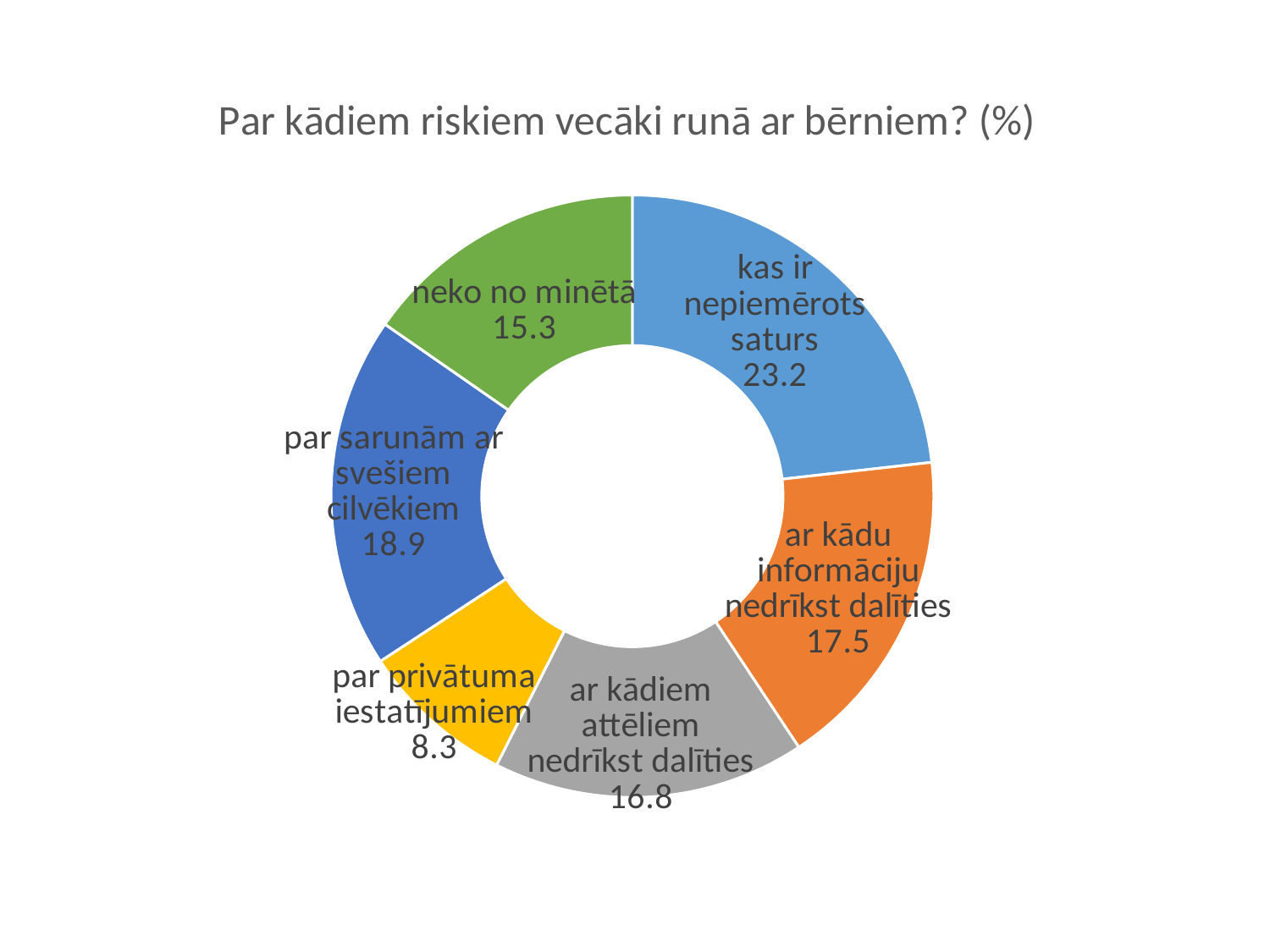
Which category has the highest value? kas ir nepiemērots saturs What is the difference between the values for 'kas ir nepiemērots saturs' and 'par privātuma iestatījumiem'? 14.9 What type of chart is shown on the slide? Doughnut chart What is the value for 'par privātuma iestatījumiem'? 8.3 Which category has the lowest value? par privātuma iestatījumiem What is the value for 'par sarunām ar svešiem cilvēkiem'? 18.9 What is the difference between the values for 'par sarunām ar svešiem cilvēkiem' and 'ar kādu informāciju nedrīkst dalīties'? 1.4 What is the value for 'neko no minētā'? 15.3 What is the value for 'kas ir nepiemērots saturs'? 23.2 What is the title of the chart? Par kādiem riskiem vecāki runā ar bērniem? (%) Which is larger: the value for 'ar kādiem attēliem nedrīkst dalīties' or 'neko no minētā'? ar kādiem attēliem nedrīkst dalīties How many categories are shown in the chart? 6